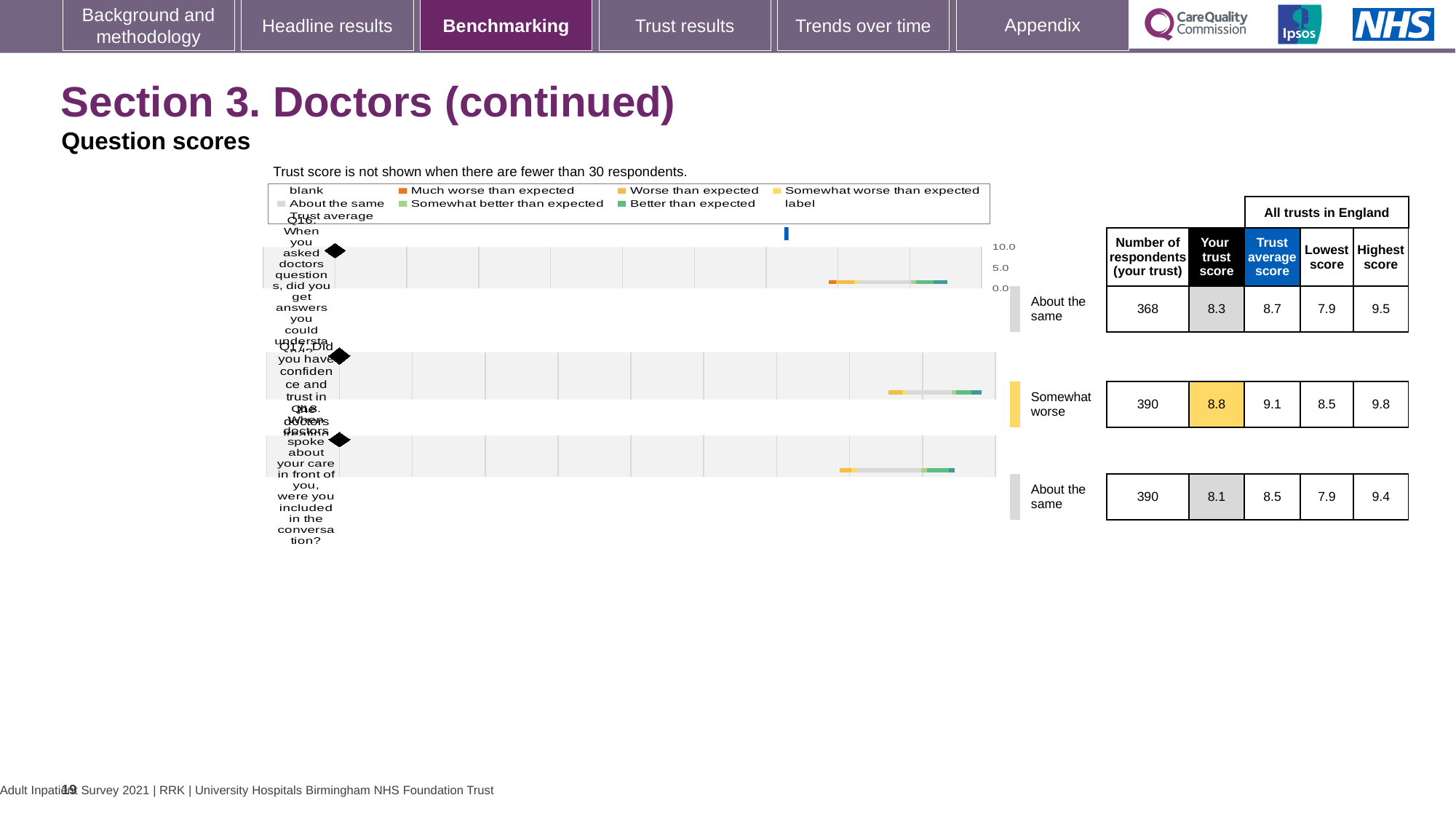
What is the highest score across all trusts in England for Q17? 9.8 Which question has the highest 'Your trust score'? Q17 For Q16, which is larger: your trust score or the trust average score? Trust average score What is the difference between the trust average score and your trust score for Q17? 0.3 Which question has the lowest 'Your trust score'? Q18 Is the trust score for Q17 greater or less than 5.0 on the chart axis? greater What is the trust average score for Q18 (When doctors spoke about your care in front of you, were you included in the conversation)? 8.5 What kind of chart is used to show the question scores on this slide? bar chart What benchmark category is shown for Q17? Somewhat worse What is the trust score for Q17 (Did you have confidence and trust in the doctors treating you)? 8.8 How many questions (categories) are plotted in the chart? 3 What is the number of respondents for Q16 (When you asked doctors questions, did you get answers you could understand)? 368